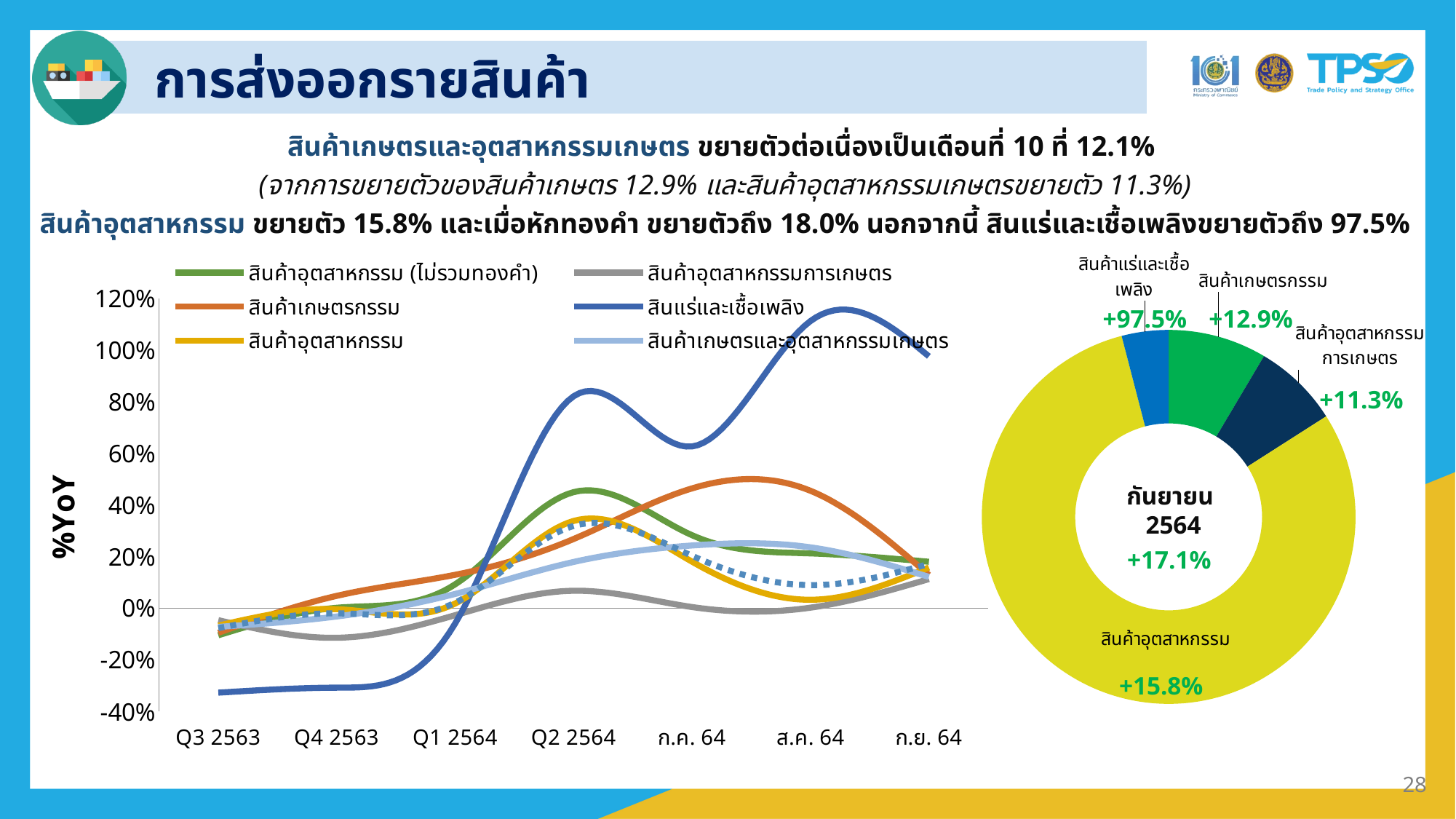
How many series does the legend of the line chart on the left list? 6 In the doughnut chart on the right, which category has the lowest value shown? สินค้าอุตสาหกรรมการเกษตร How many points are on the x axis of the line chart on the left? 7 In the doughnut chart on the right, what is the value shown for สินค้าอุตสาหกรรมการเกษตร? +11.3% What kind of chart is the chart on the left of the slide? line chart In the doughnut chart on the right, what is the value shown for สินค้าแร่และเชื้อเพลิง? +97.5% In the line chart on the left, is the value for สินแร่และเชื้อเพลิง at Q3 2563 greater or less than -20%? less In the line chart on the left, which series reaches the highest value over the period shown? สินแร่และเชื้อเพลิง In the doughnut chart on the right, what value is shown in the centre for กันยายน 2564? +17.1% In the doughnut chart on the right, what is the difference between the values shown for สินค้าอุตสาหกรรม and สินค้าเกษตรกรรม? 2.9 percentage points What kind of chart is the chart on the right of the slide? doughnut chart In the line chart on the left, is the value for สินแร่และเชื้อเพลิง at ส.ค. 64 greater or less than 100%? greater